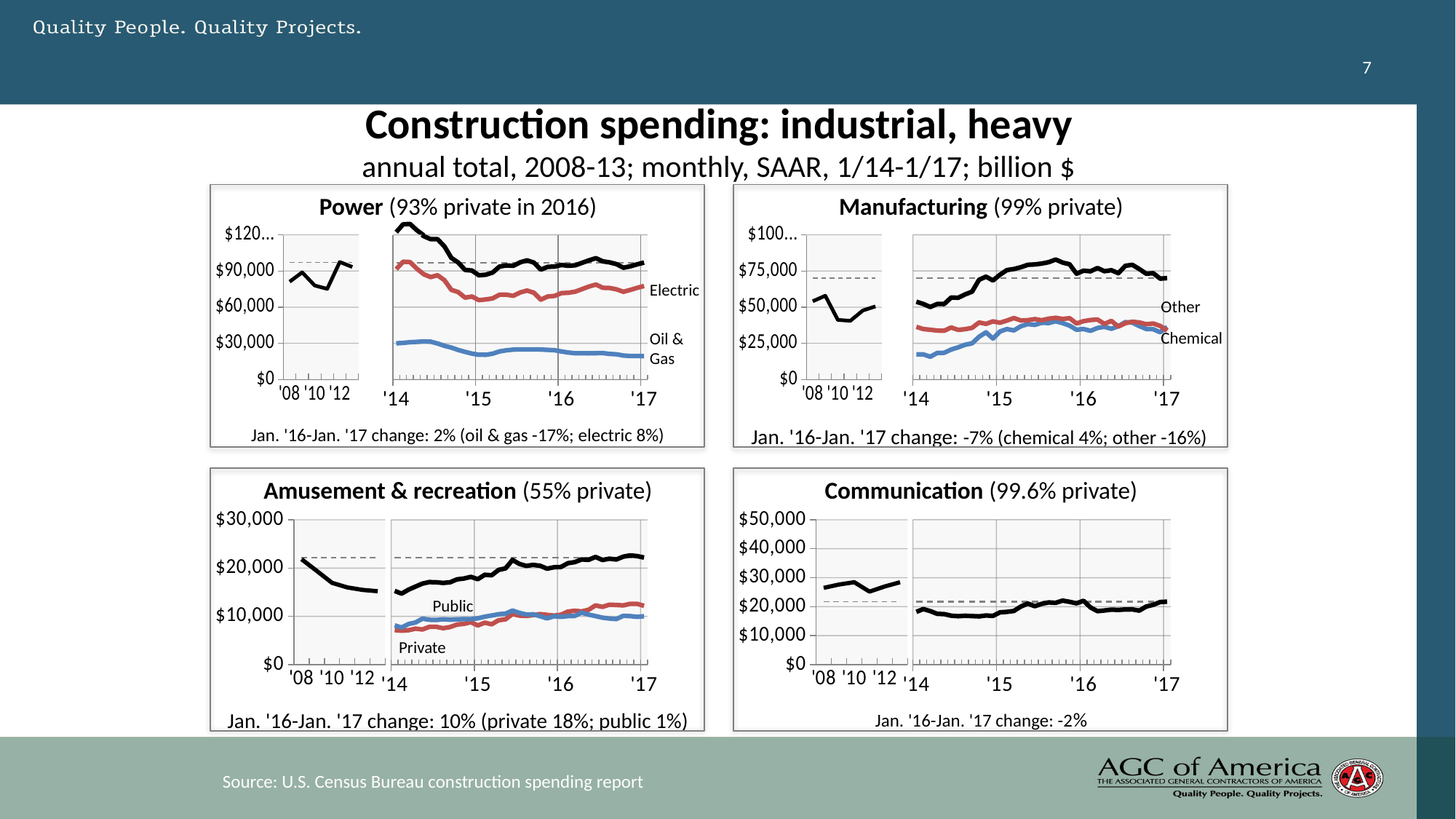
In the Communication chart, is the value at '14 greater or less than $20,000? less In the Manufacturing chart, is the value of the Chemical line at '17 greater or less than $25,000? greater In the Amusement & recreation chart, does the top (total) line rise or fall from '14 to '17? rise How many charts are shown on the slide? 4 What kind of chart is the Power chart? line chart In the Power chart, does the Oil & Gas line rise or fall from '14 to '17? fall In the Amusement & recreation chart, which line is higher at '17, Private or Public? Private According to the Manufacturing chart title, what share of manufacturing construction spending is private? 99% In the Power chart, is the value of the Electric line at '17 greater or less than $60,000? greater What Jan. '16-Jan. '17 change is printed under the Communication chart? -2% In the Power chart, which of the two labelled component lines is higher in '17, Electric or Oil & Gas? Electric